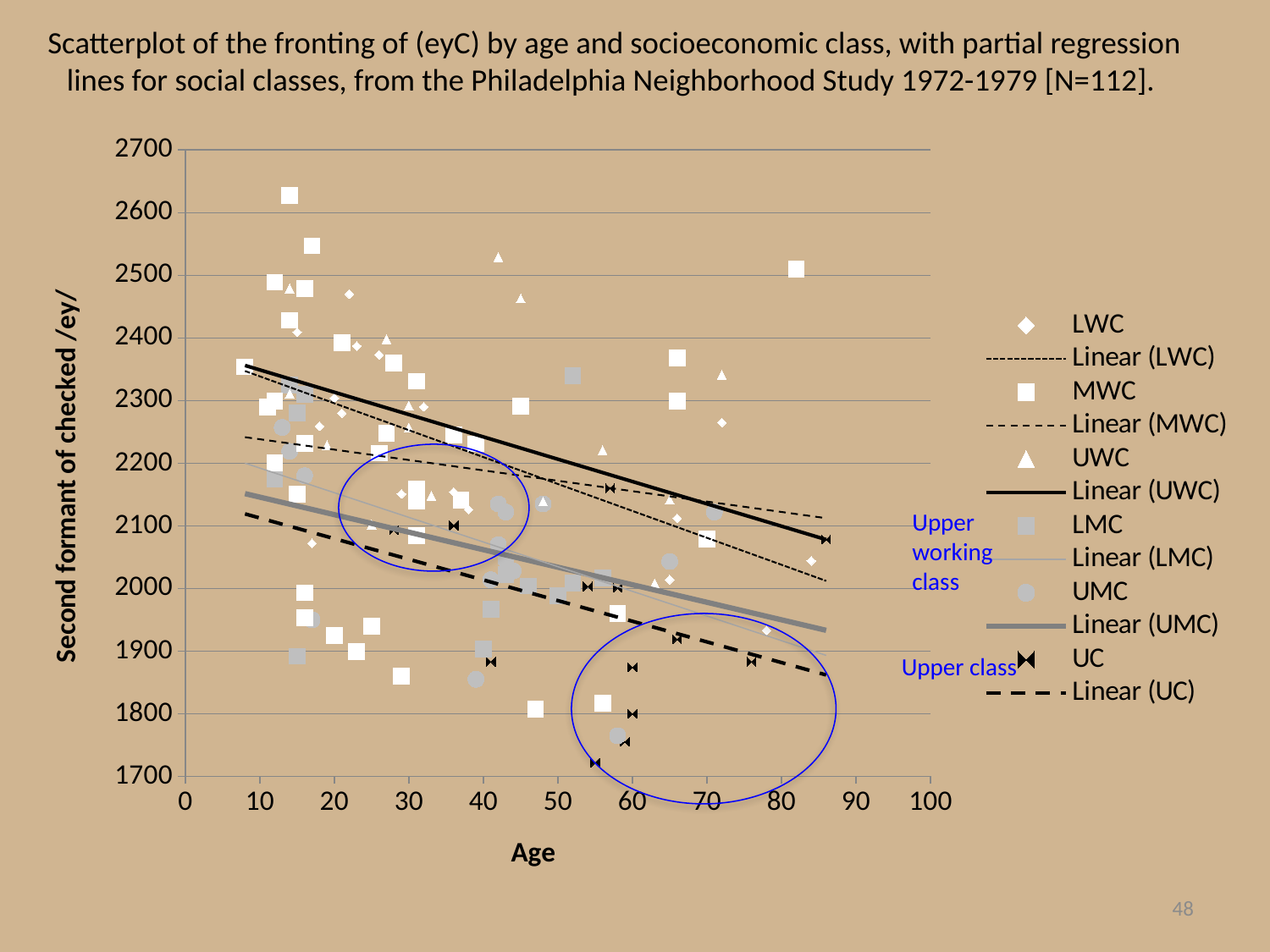
Is the Linear (UWC) line at age 10 greater or less than 2300? greater How many socioeconomic class data series (excluding the linear trend lines) are plotted? 6 Which regression line is the lowest across the age range? Linear (UC) What is the title of the y axis? Second formant of checked /ey/ What kind of chart is shown on the slide? Scatter chart What is the title of the x axis? Age Is the Linear (UC) line at age 10 greater or less than 2200? less At age 80, which is higher: the Linear (UWC) line or the Linear (UC) line? Linear (UWC) Which regression line is the highest across the age range? Linear (UWC) Do the regression lines rise or fall as age increases? Fall How many entries does the legend list? 12 Which series contains the single highest plotted point on the chart? MWC